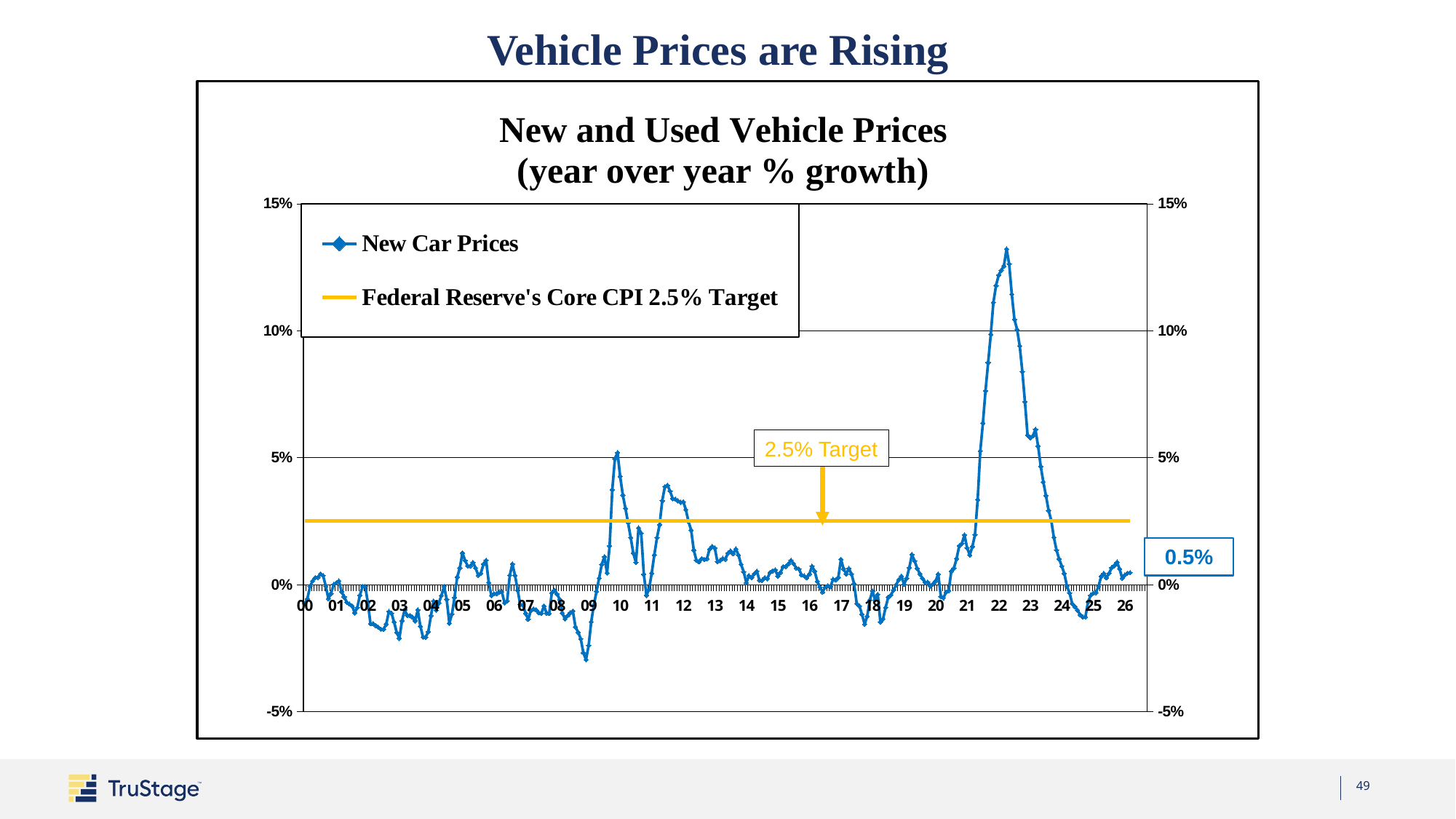
What is the title of the chart? New and Used Vehicle Prices (year over year % growth) What kind of chart is shown on the slide? line chart In which year on the x axis does New Car Prices growth reach its lowest point? 08 What colour is the Federal Reserve's Core CPI 2.5% Target line? yellow What is the most recent New Car Prices value labeled at the right end of the line? 0.5% In which year on the x axis does New Car Prices growth reach its highest point? 22 Which peak is higher for New Car Prices: the one around 10 or the one around 22? 22 Do New Car Prices values rise or fall from 22 to 24? fall How many series does the legend list? 2 What value does the Federal Reserve's Core CPI target line represent? 2.5% Is the peak New Car Prices value in 22 greater or less than 10%? greater Is the lowest New Car Prices value in 09 greater or less than 0%? less